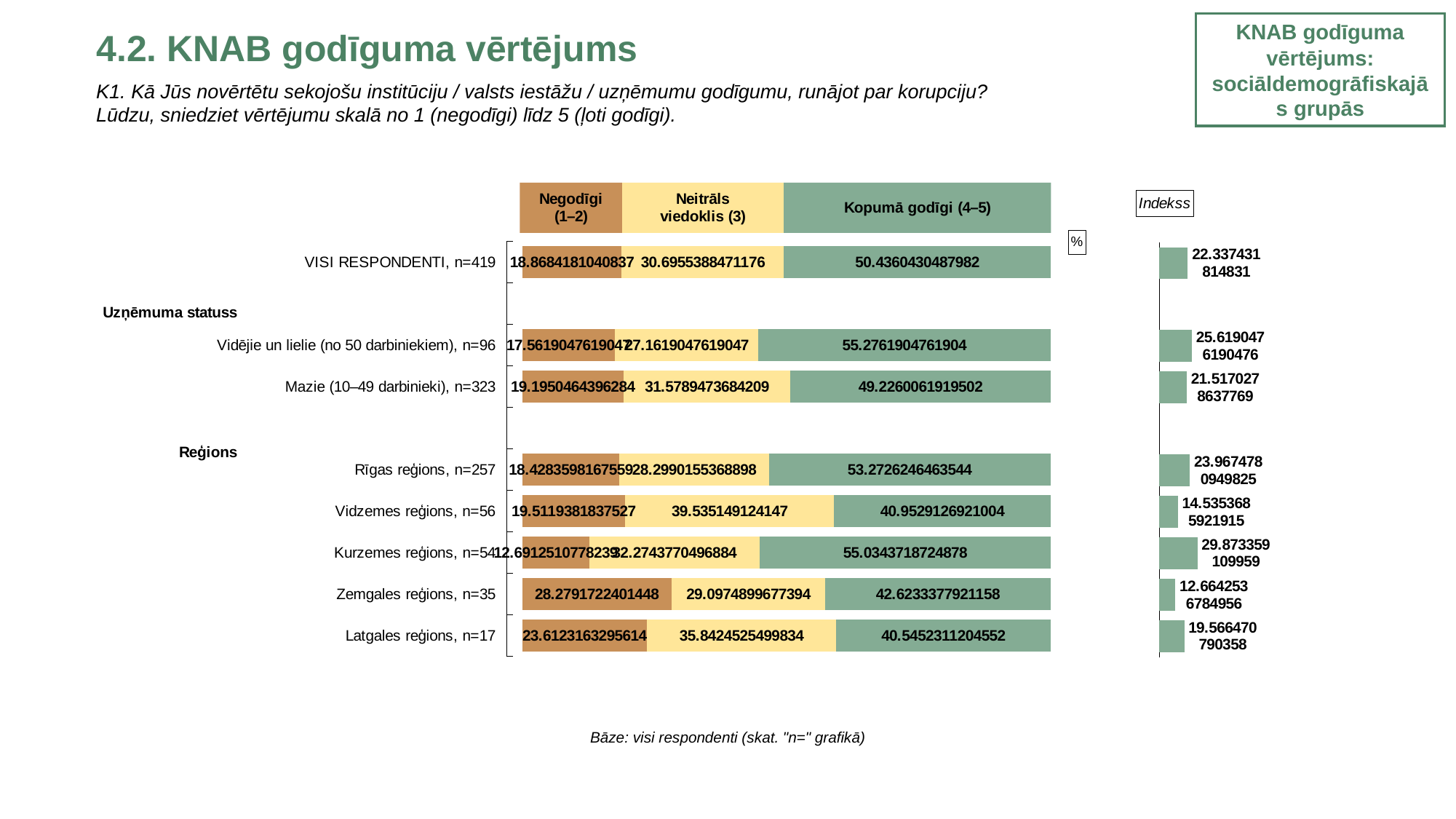
How many respondent groups (bars) are plotted in the main stacked bar chart? 8 In the main stacked bar chart, what is the Neitrāls viedoklis (3) value for Latgales reģions, n=17? 35.8424525499834 How many series does the legend of the main stacked bar chart list? 3 In the Indekss chart, which group has the highest index value? Kurzemes reģions, n=54 In the main stacked bar chart, what colour represents the Kopumā godīgi (4–5) series? Green In the main stacked bar chart, which group has the highest Negodīgi (1–2) value? Zemgales reģions, n=35 In the Indekss chart, which group has the lowest index value? Zemgales reģions, n=35 What kind of chart is used to show the Negodīgi / Neitrāls viedoklis / Kopumā godīgi breakdown? Stacked bar chart In the Indekss chart, what is the index value for Zemgales reģions, n=35? 12.6642536784956 In the main stacked bar chart, for Vidzemes reģions, n=56, which is larger: the Neitrāls viedoklis (3) value or the Kopumā godīgi (4–5) value? Kopumā godīgi (4–5) In the main stacked bar chart, what is the Kopumā godīgi (4–5) value for Vidējie un lielie (no 50 darbiniekiem), n=96? 55.2761904761904 In the main stacked bar chart, which region has the highest Kopumā godīgi (4–5) value? Kurzemes reģions, n=54